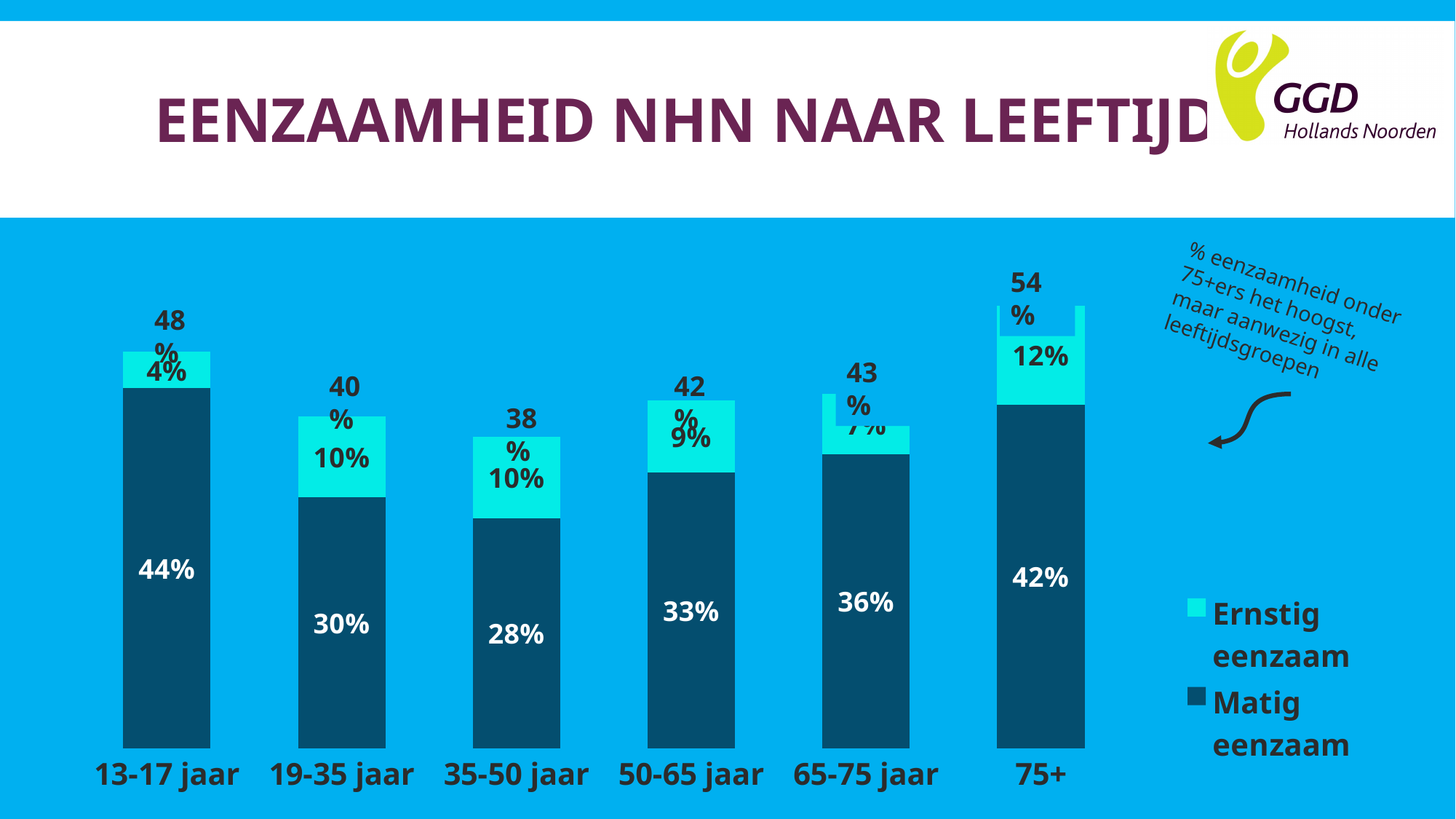
What is the difference between the 'Matig eenzaam' values for 13-17 jaar and 19-35 jaar? 14% Which is larger: the 'Ernstig eenzaam' value for 19-35 jaar or for 13-17 jaar? 19-35 jaar What is the value for 'Ernstig eenzaam' in the 65-75 jaar group? 7% Which age group has the highest total percentage of loneliness? 75+ What is the value for 'Matig eenzaam' in the 35-50 jaar group? 28% Which age group has the lowest total percentage of loneliness? 35-50 jaar How many series does the legend list? 2 What type of chart is shown on the slide? stacked bar chart What is the value for 'Matig eenzaam' in the 13-17 jaar group? 44% What is the total percentage shown above the bar for the 50-65 jaar group? 42% What is the value for 'Ernstig eenzaam' in the 75+ group? 12% How many age groups are shown in the chart? 6